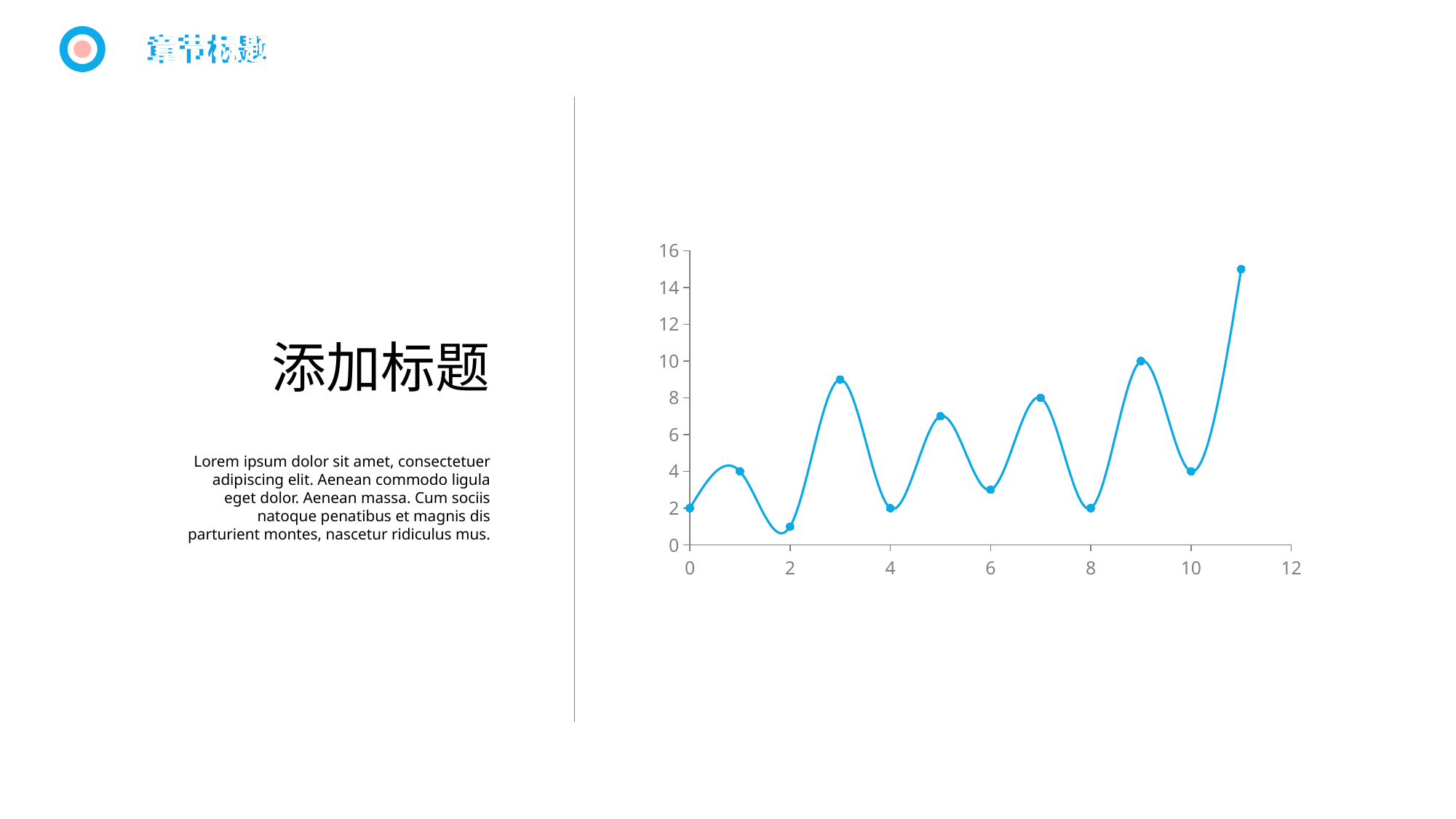
Is the last point on the line higher or lower than the first point? higher What is the value of the point at x = 4? 2 Is the value of the rightmost point greater or less than 14? greater What is the value of the point at x = 0? 2 How many data points are plotted on the line? 12 What kind of chart is shown on the slide? line chart Which is larger, the value at x = 10 or the value at x = 8? x = 10 What is the difference between the value at x = 10 and the value at x = 0? 2 Is the value of the point at x = 2 greater or less than 2? less What is the highest value shown on the vertical axis? 16 What is the value of the point at x = 10? 4 Is the value of the point at x = 6 greater or less than 4? less